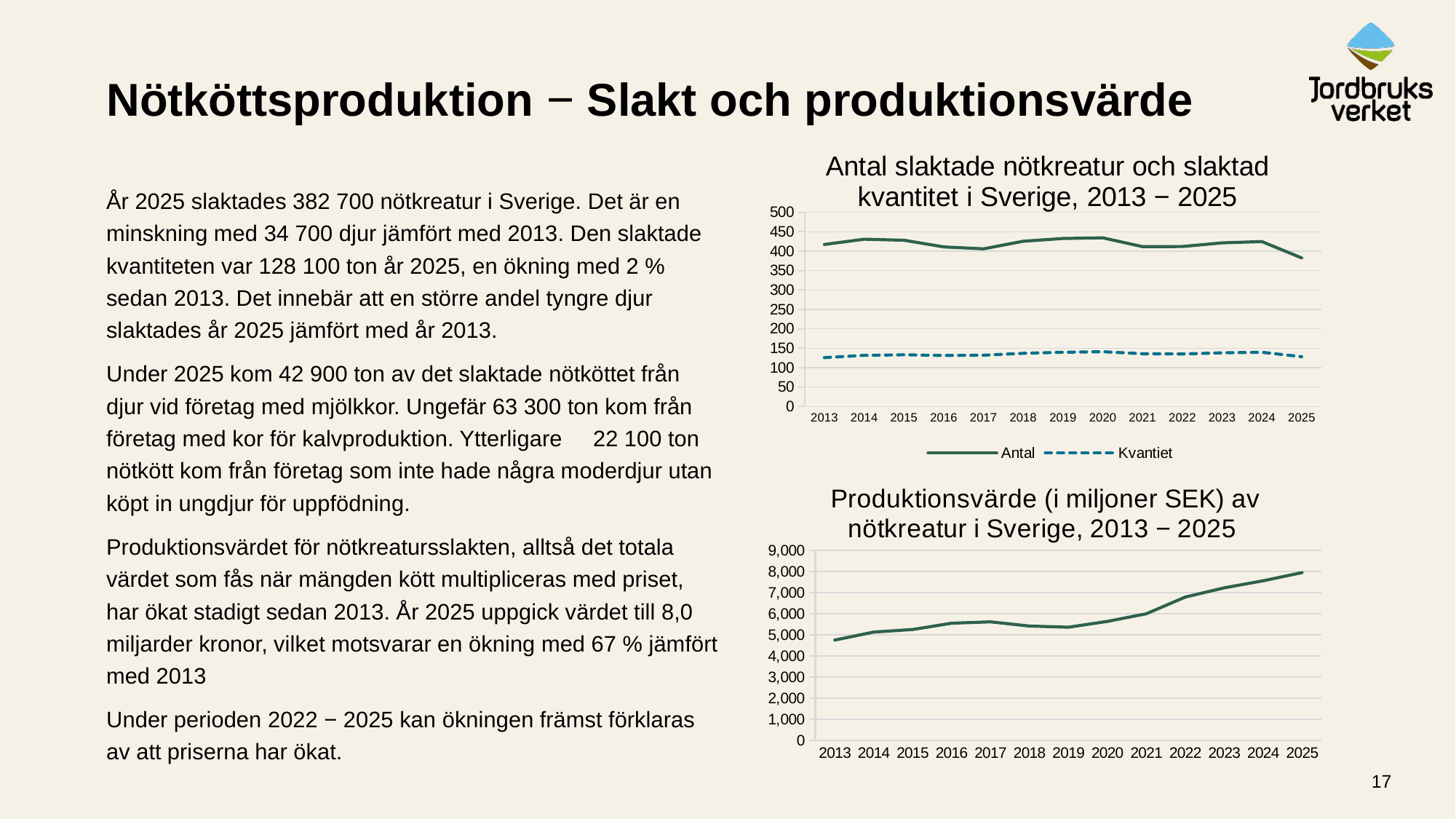
In the top chart (Antal slaktade nötkreatur och slaktad kvantitet), how many years are shown on the x axis? 13 How many series does the legend of the top chart (Antal slaktade nötkreatur och slaktad kvantitet) list? 2 In the bottom chart (Produktionsvärde), which year has the highest value? 2025 What kind of chart is the chart titled "Produktionsvärde (i miljoner SEK) av nötkreatur i Sverige, 2013 − 2025"? line chart In the bottom chart (Produktionsvärde), do the values generally rise or fall from 2013 to 2025? rise In the bottom chart (Produktionsvärde), is the value for 2013 greater or less than 5,000? less In the top chart (Antal slaktade nötkreatur och slaktad kvantitet), is the value for Antal in 2025 greater or less than 400? less What kind of chart is the chart titled "Antal slaktade nötkreatur och slaktad kvantitet i Sverige, 2013 − 2025"? line chart In the top chart, which series is drawn with a dashed line? Kvantiet In the top chart (Antal slaktade nötkreatur och slaktad kvantitet), is the value for Kvantitet in 2020 greater or less than 100? greater In the top chart (Antal slaktade nötkreatur och slaktad kvantitet), which year has the lowest value for Antal? 2025 In the top chart (Antal slaktade nötkreatur och slaktad kvantitet), which series has the larger value in 2020, Antal or Kvantitet? Antal